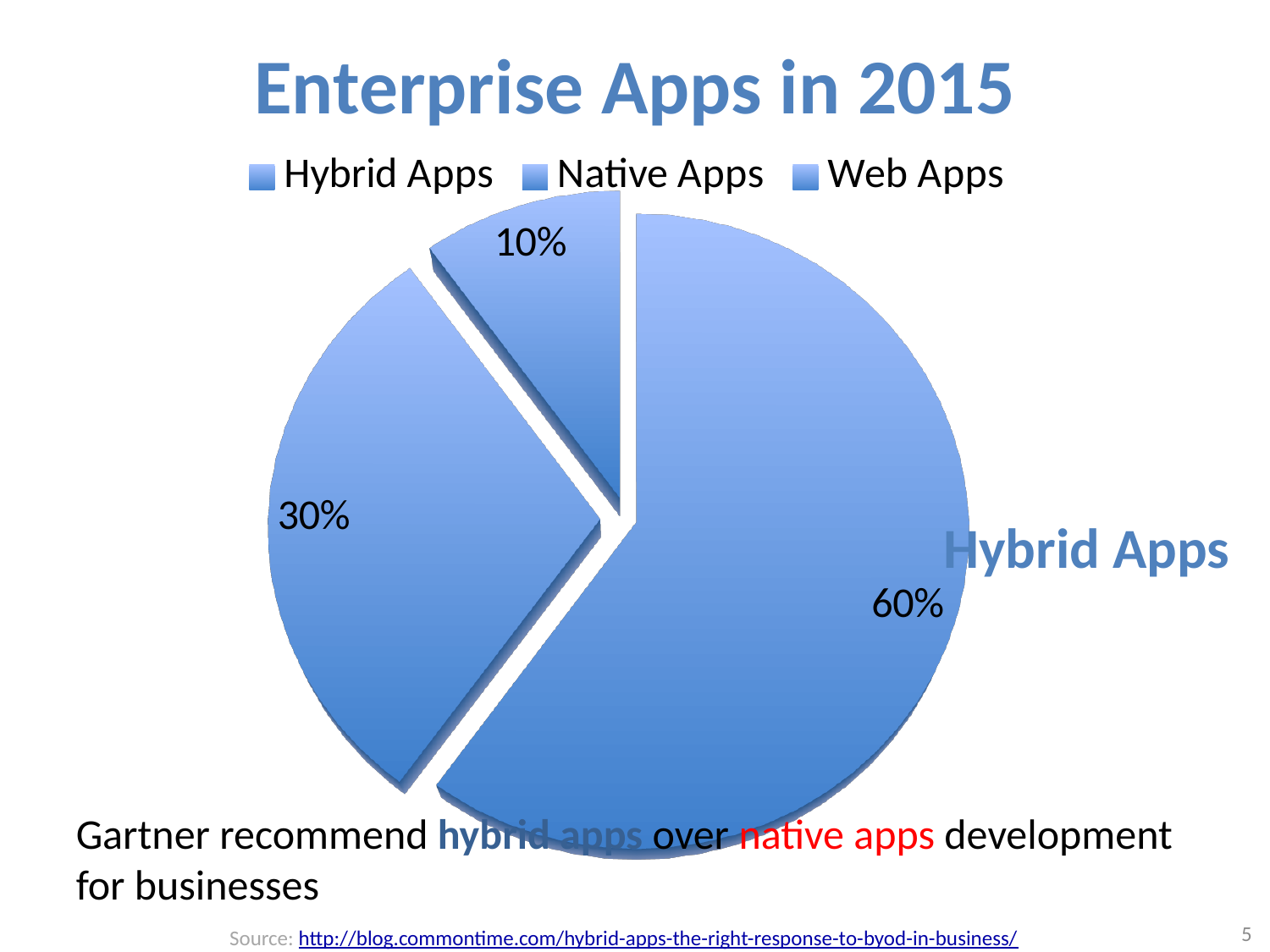
What share of the pie is Native Apps? 30% What share of the pie is Web Apps? 10% How many slices does the pie chart have? 3 Which category has the largest slice of the pie? Hybrid Apps What are the three legend entries, in order? Hybrid Apps, Native Apps, Web Apps Which category has the smallest slice of the pie? Web Apps Which is larger, the Native Apps share or the Web Apps share? Native Apps What is the title of the chart? Enterprise Apps in 2015 What is the difference between the Hybrid Apps share and the Native Apps share? 30% What kind of chart is shown on the slide? pie chart How many series does the legend list? 3 What share of the pie is Hybrid Apps? 60%